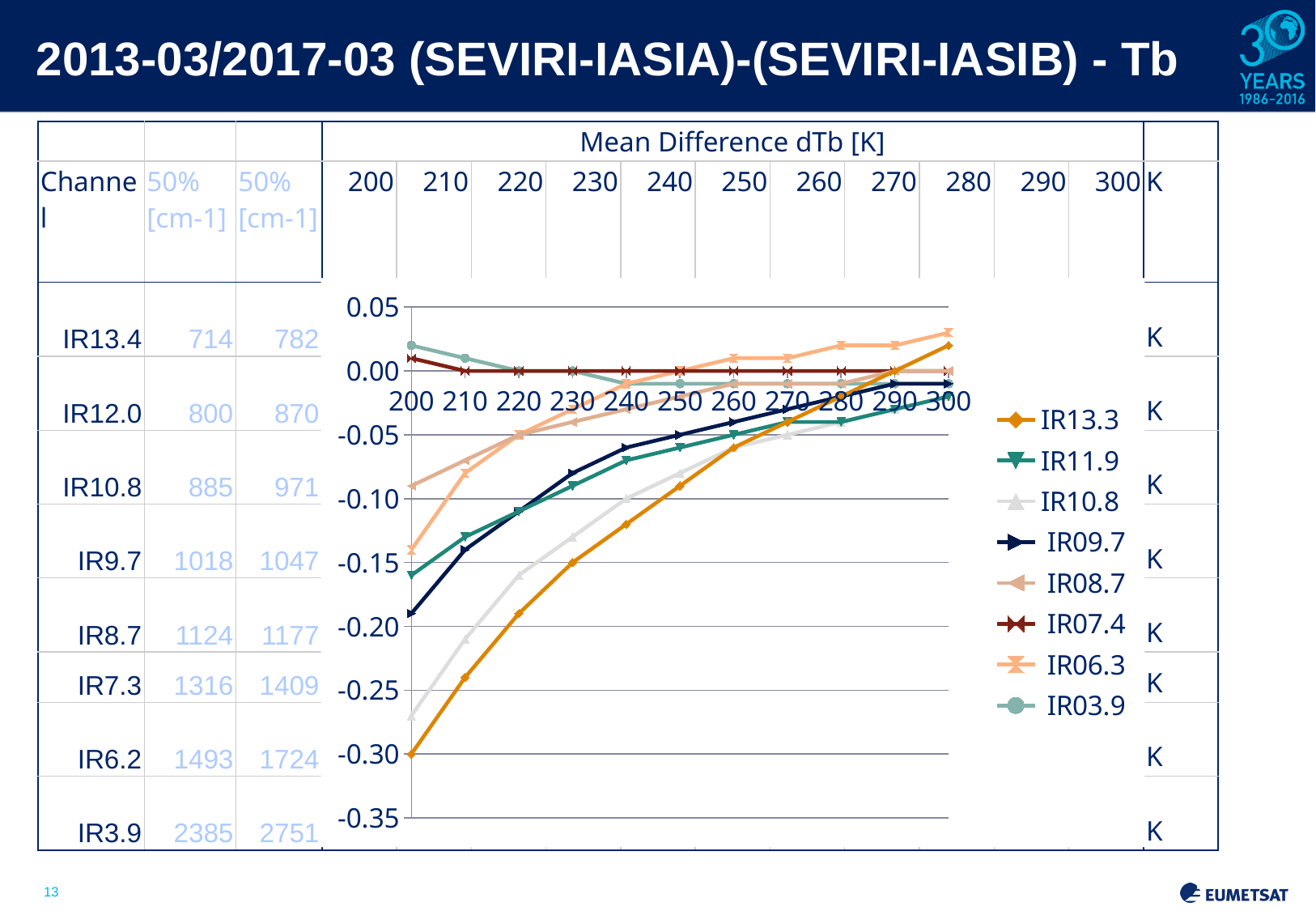
What is the title shown above the chart? Mean Difference dTb [K] Is the value for IR10.8 at x = 200 greater or less than -0.20? less Do the values for IR13.3 rise or fall as x increases from 200 to 300? rise Is the value for IR08.7 at x = 200 greater or less than -0.05? less Do the values for IR03.9 rise or fall as x increases from 200 to 250? fall Is the value for IR06.3 at x = 200 greater or less than -0.10? less How many x-axis tick values are shown on the chart? 11 At x = 200, which is larger: the value for IR11.9 or the value for IR09.7? IR11.9 How many series does the chart legend list? 8 Which series has the lowest value at x = 200? IR13.3 What kind of chart is shown on the slide? line chart